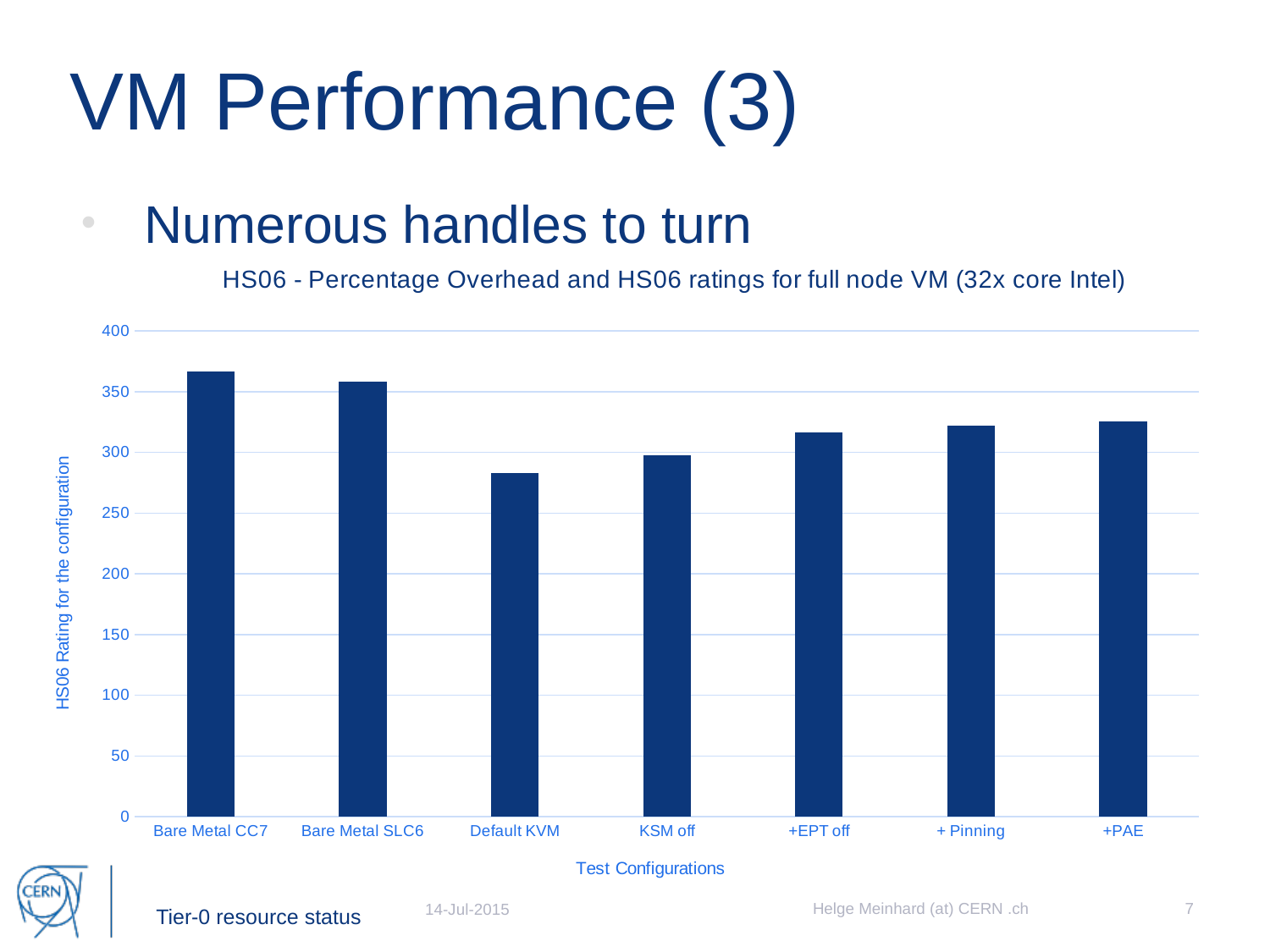
Which test configuration has the lowest HS06 rating? Default KVM Is the HS06 rating for +EPT off greater or less than 300? greater What is the title of the chart? HS06 - Percentage Overhead and HS06 ratings for full node VM (32x core Intel) Is the HS06 rating for Bare Metal CC7 greater or less than 350? greater Is the HS06 rating for + Pinning greater or less than 350? less Which has the higher HS06 rating, KSM off or +EPT off? +EPT off What kind of chart is shown on the slide? bar chart Which test configuration has the highest HS06 rating? Bare Metal CC7 What is the label of the x axis of the chart? Test Configurations Which has the higher HS06 rating, Bare Metal CC7 or Bare Metal SLC6? Bare Metal CC7 How many test configurations are plotted in the chart? 7